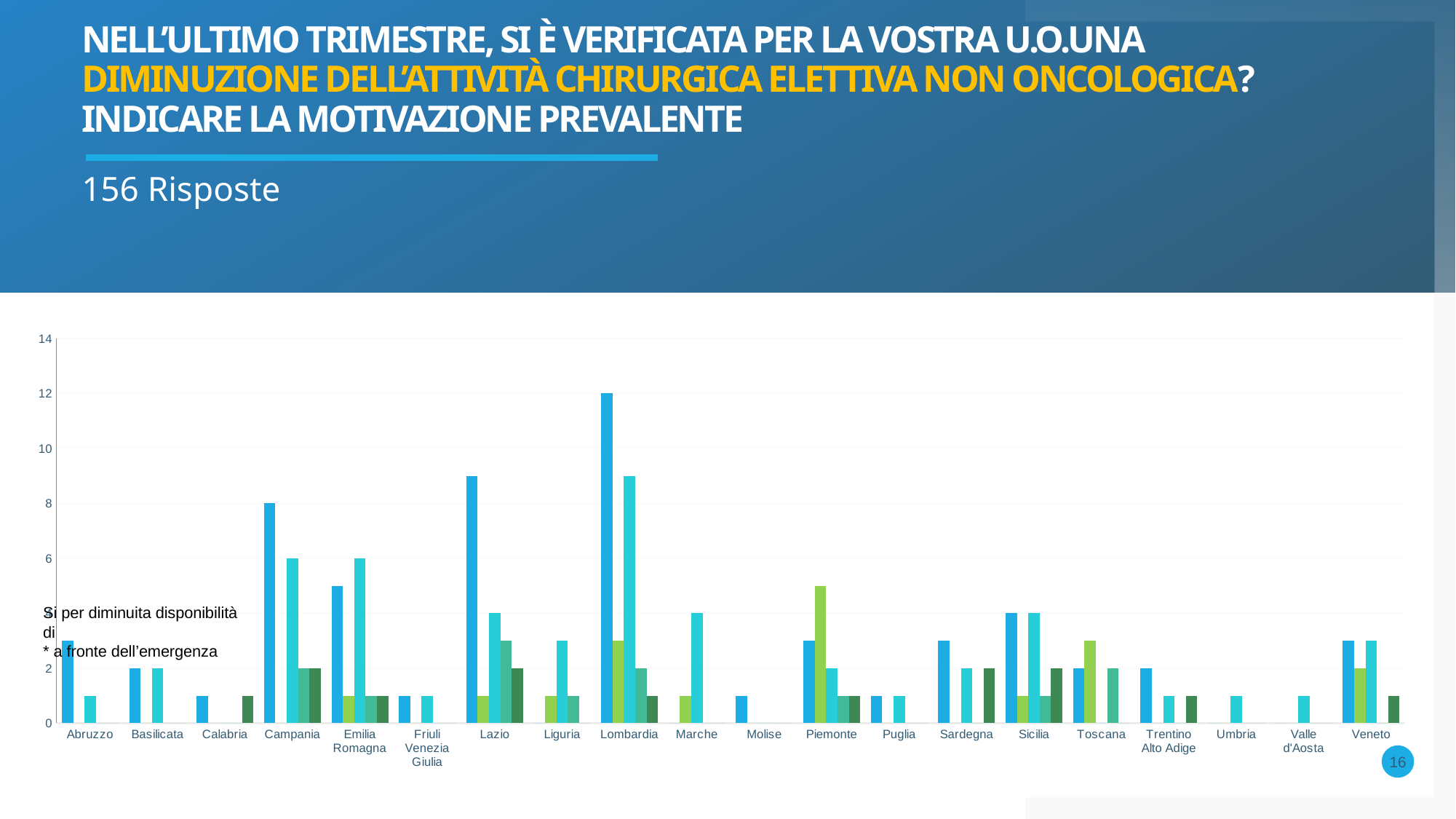
Which region has a taller maximum bar, Campania or Emilia Romagna? Campania Which region has the tallest bar in the chart? Lombardia What value does the tallest bar for Emilia Romagna reach? 6 What value does the tallest bar in the chart (for Lombardia) reach? 12 What is the highest value shown on the y axis of the chart? 14 Is the tallest bar for Lazio greater or less than 8? greater Which region has a taller maximum bar, Lombardia or Lazio? Lombardia Is the only bar for Molise greater or less than 2? less Is the tallest bar for Piemonte greater or less than 4? greater What value does the tallest bar for Campania reach? 8 How many regions are listed along the x axis of the chart? 20 What kind of chart is shown on the slide? bar chart